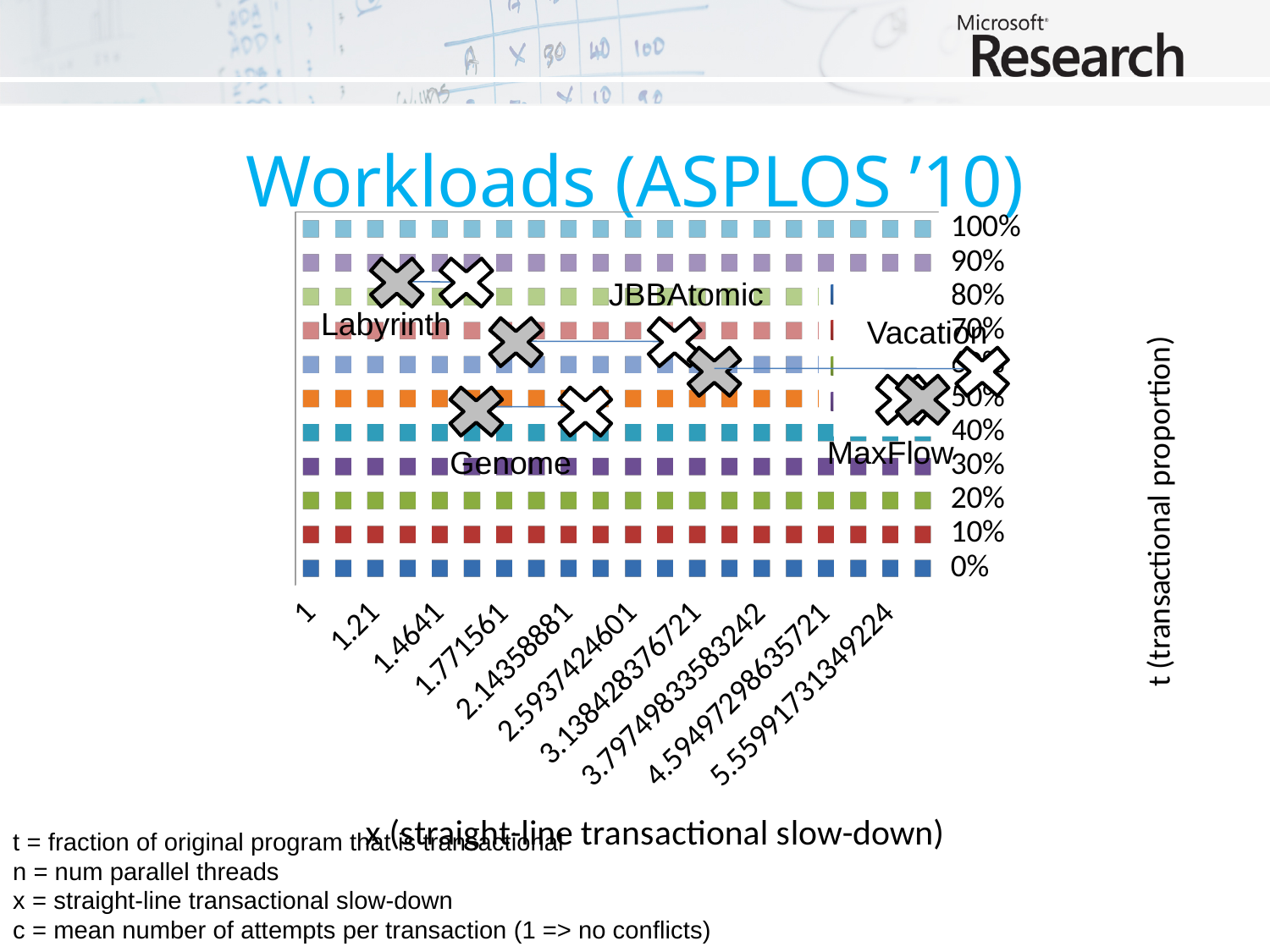
Is the transactional proportion (t) for Labyrinth greater or less than 50%? greater What is the highest value shown on the vertical (t) axis of the chart? 100% What is the label of the vertical axis of the chart? t (transactional proportion) What is the first tick label on the x axis of the chart? 1 Which labelled workload has the highest transactional proportion (t) on the chart? Labyrinth What is the lowest value shown on the vertical (t) axis of the chart? 0% Is the transactional proportion (t) for MaxFlow greater or less than 80%? less Is the transactional proportion (t) for Genome greater or less than 80%? less How many workloads are labelled with X markers on the chart? 5 Which has the higher transactional proportion (t) on the chart, Labyrinth or Genome? Labyrinth What is the title of the chart on the slide? Workloads (ASPLOS '10) How many tick labels are shown along the x axis of the chart? 10